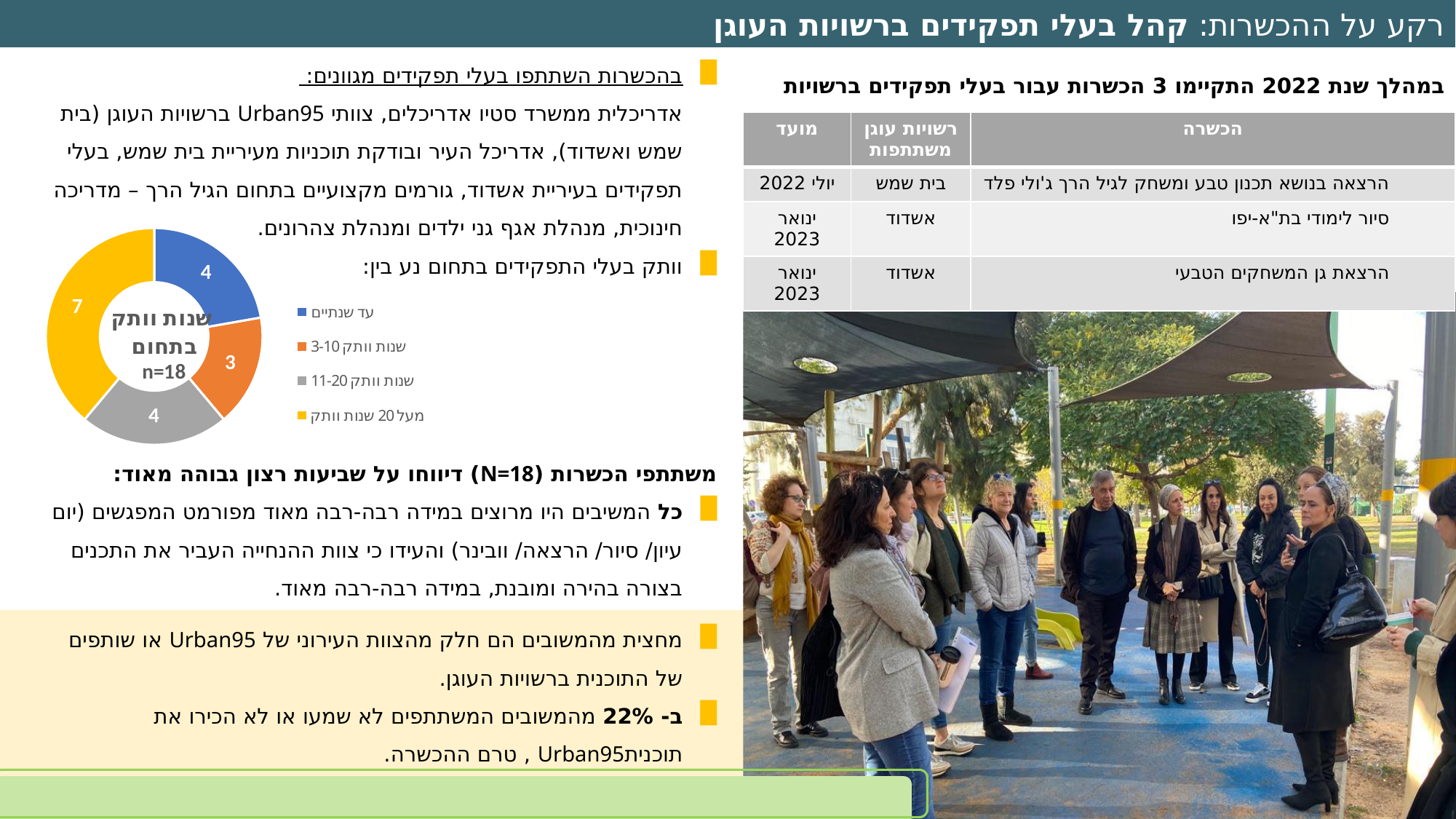
How many categories does the donut chart show? 4 What is the value for '3-10 שנות וותק' in the donut chart? 3 Which colour represents 'מעל 20 שנות וותק' in the donut chart? Yellow What is the value for '11-20 שנות וותק' in the donut chart? 4 What is the value for 'מעל 20 שנות וותק' in the donut chart? 7 What is the difference between the values for 'מעל 20 שנות וותק' and '3-10 שנות וותק'? 4 Which category has the lowest value in the donut chart? 3-10 שנות וותק Which is larger in the donut chart: 'מעל 20 שנות וותק' or 'עד שנתיים'? מעל 20 שנות וותק Which category has the highest value in the donut chart? מעל 20 שנות וותק What is the value for 'עד שנתיים' in the donut chart? 4 What is the title of the donut chart? שנות וותק בתחום n=18 What kind of chart is shown on the slide? Donut (pie) chart